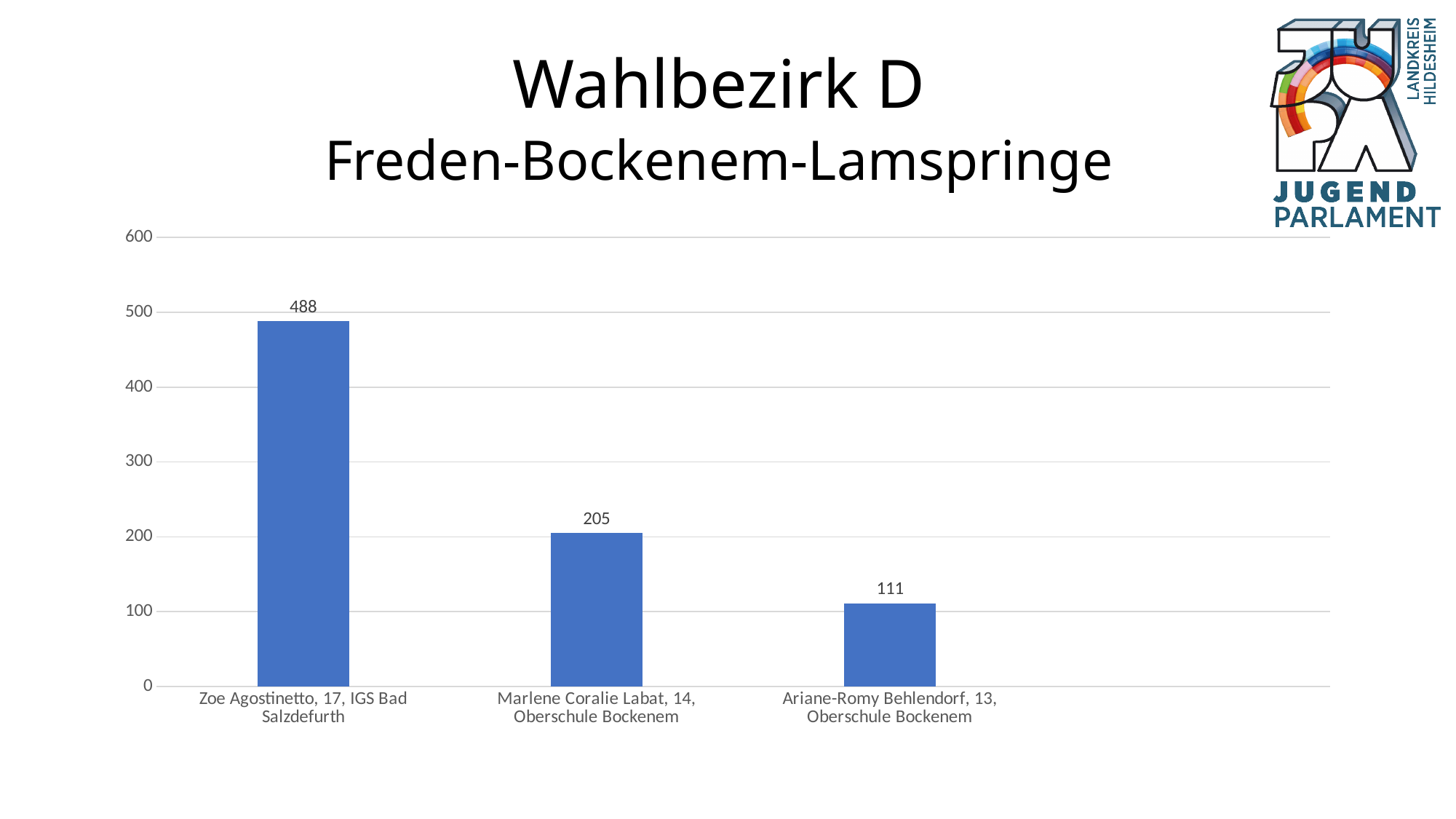
Which candidate has the lowest value? Ariane-Romy Behlendorf, 13, Oberschule Bockenem What is the difference between the values for Marlene Coralie Labat and Ariane-Romy Behlendorf? 94 What kind of chart is shown on the slide? bar chart What is the difference between the values for Zoe Agostinetto and Marlene Coralie Labat? 283 Which is larger, the value for Marlene Coralie Labat or the value for Ariane-Romy Behlendorf? Marlene Coralie Labat Is the value for Zoe Agostinetto greater or less than 400? greater Do the values rise or fall from left to right across the chart? fall What value is shown for Zoe Agostinetto, 17, IGS Bad Salzdefurth? 488 How many candidates are shown in the chart? 3 What value is shown for Ariane-Romy Behlendorf, 13, Oberschule Bockenem? 111 What value is shown for Marlene Coralie Labat, 14, Oberschule Bockenem? 205 Which candidate has the highest value? Zoe Agostinetto, 17, IGS Bad Salzdefurth